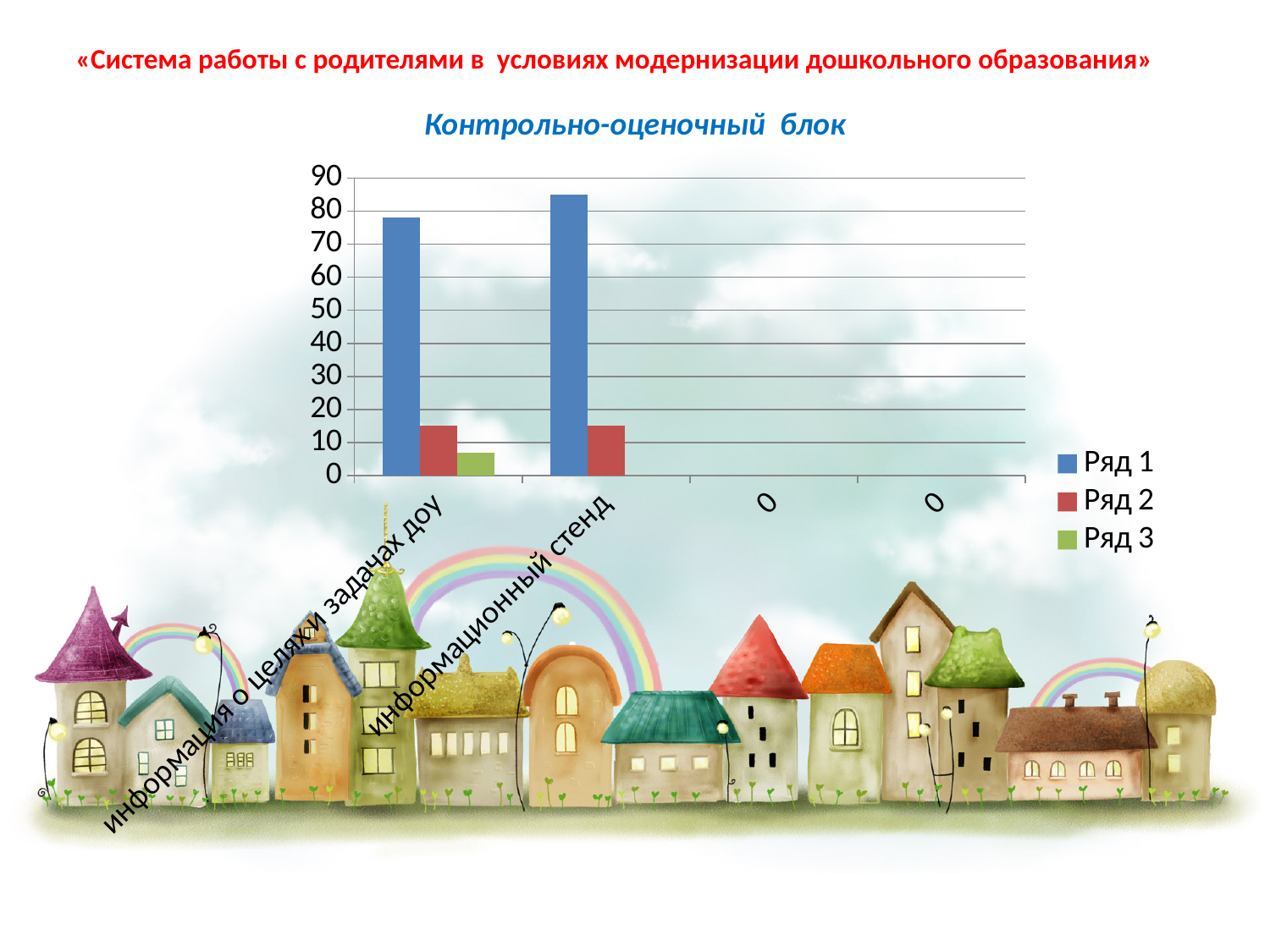
How many series does the legend list? 3 Is the value of Ряд 2 for "информационный стенд" greater or less than 20? less Which series has the lowest value for "информация о целях и задачах доу"? Ряд 3 Which colour represents Ряд 1 in the legend? blue What kind of chart is shown on the slide? bar chart Is the value of Ряд 2 for "информация о целях и задачах доу" greater or less than 10? greater Which series has the highest value for "информация о целях и задачах доу"? Ряд 1 What is the title of the chart? Контрольно-оценочный блок Is the value of Ряд 1 for "информация о целях и задачах доу" greater or less than 70? greater For Ряд 1, which category has the larger value: "информация о целях и задачах доу" or "информационный стенд"? информационный стенд